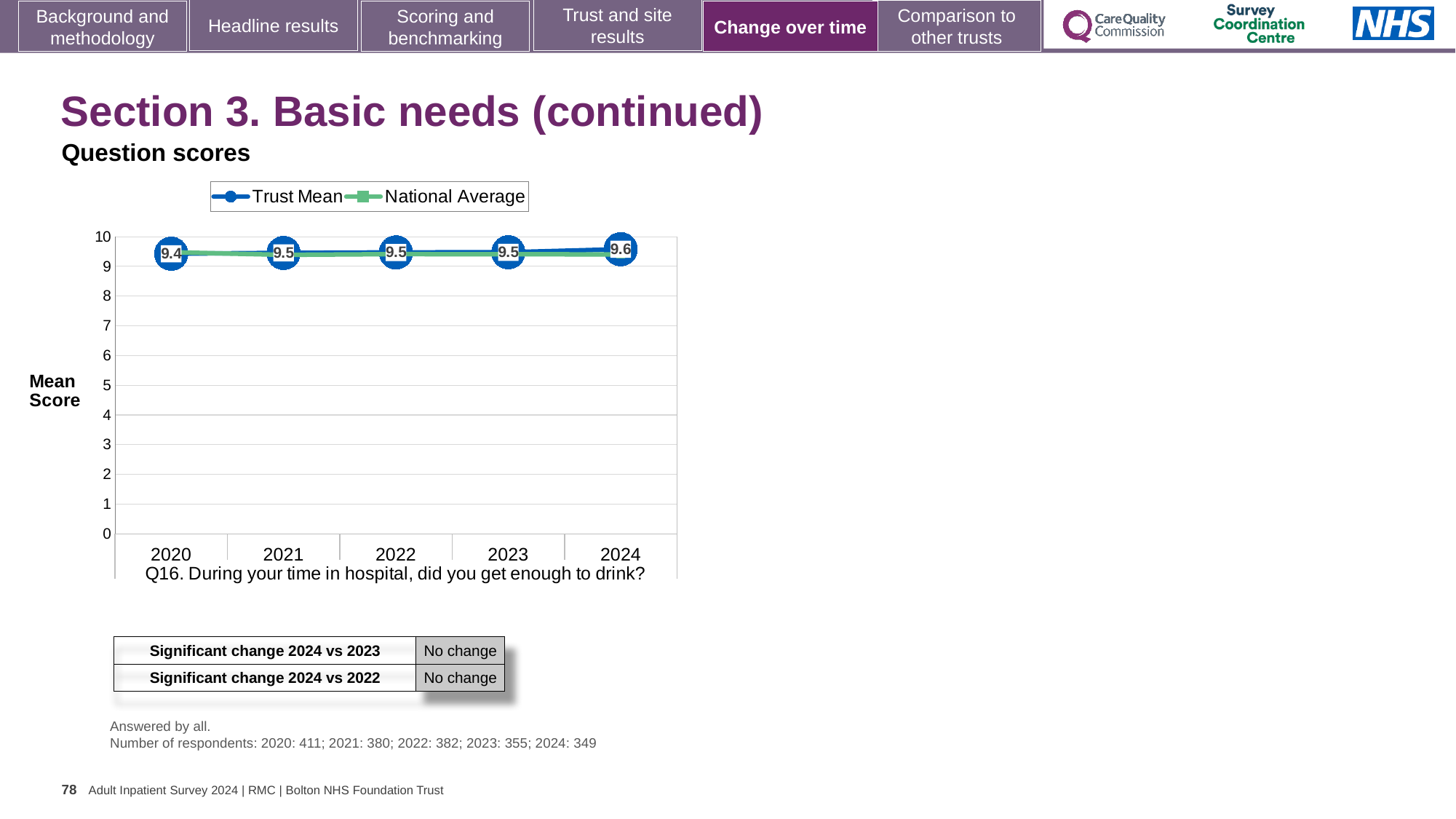
Is the National Average value for 2024 greater or less than 5? greater What is the Trust Mean score for 2020? 9.4 What is the difference between the Trust Mean score in 2024 and in 2020? 0.2 In which year is the Trust Mean score highest? 2024 How many years are plotted on the x axis? 5 Which year has the larger Trust Mean score, 2020 or 2024? 2024 Does the Trust Mean score rise or fall from 2020 to 2024? Rise What kind of chart is shown on the slide? Line chart In which year is the Trust Mean score lowest? 2020 What is the Trust Mean score for 2022? 9.5 How many series does the legend list? 2 What is the Trust Mean score for 2024? 9.6